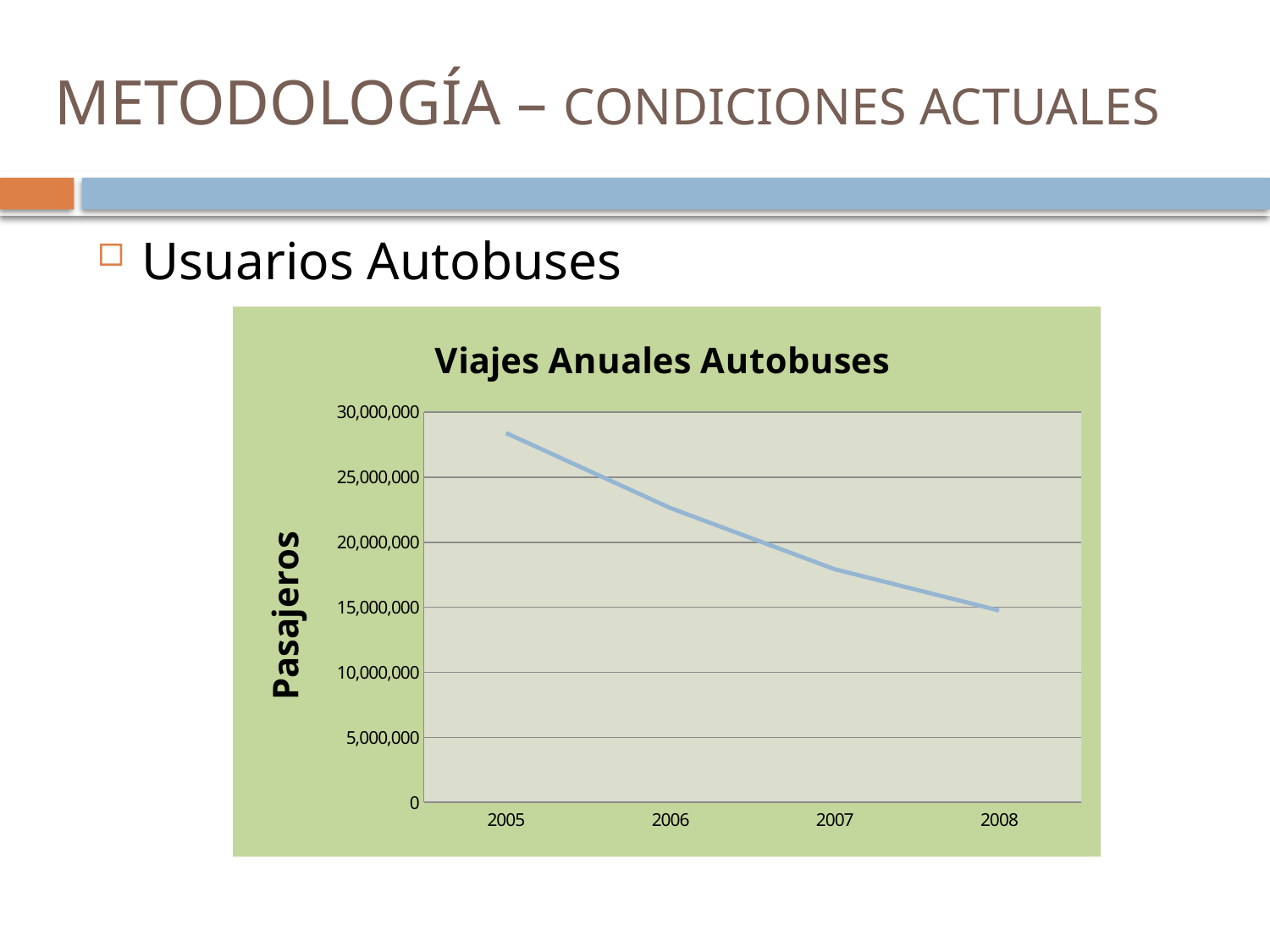
How many years are plotted on the x axis of the chart? 4 What kind of chart is shown on the slide? line chart Which year has the highest number of passengers? 2005 Is the value for 2007 greater or less than 20,000,000? less Is the value for 2005 greater or less than 25,000,000? greater Which year has the lowest number of passengers? 2008 What is the title of the chart? Viajes Anuales Autobuses Do the values rise or fall from 2005 to 2008? fall Is the value for 2006 greater or less than 25,000,000? less What is the label on the vertical axis of the chart? Pasajeros Which year has more passengers, 2006 or 2008? 2006